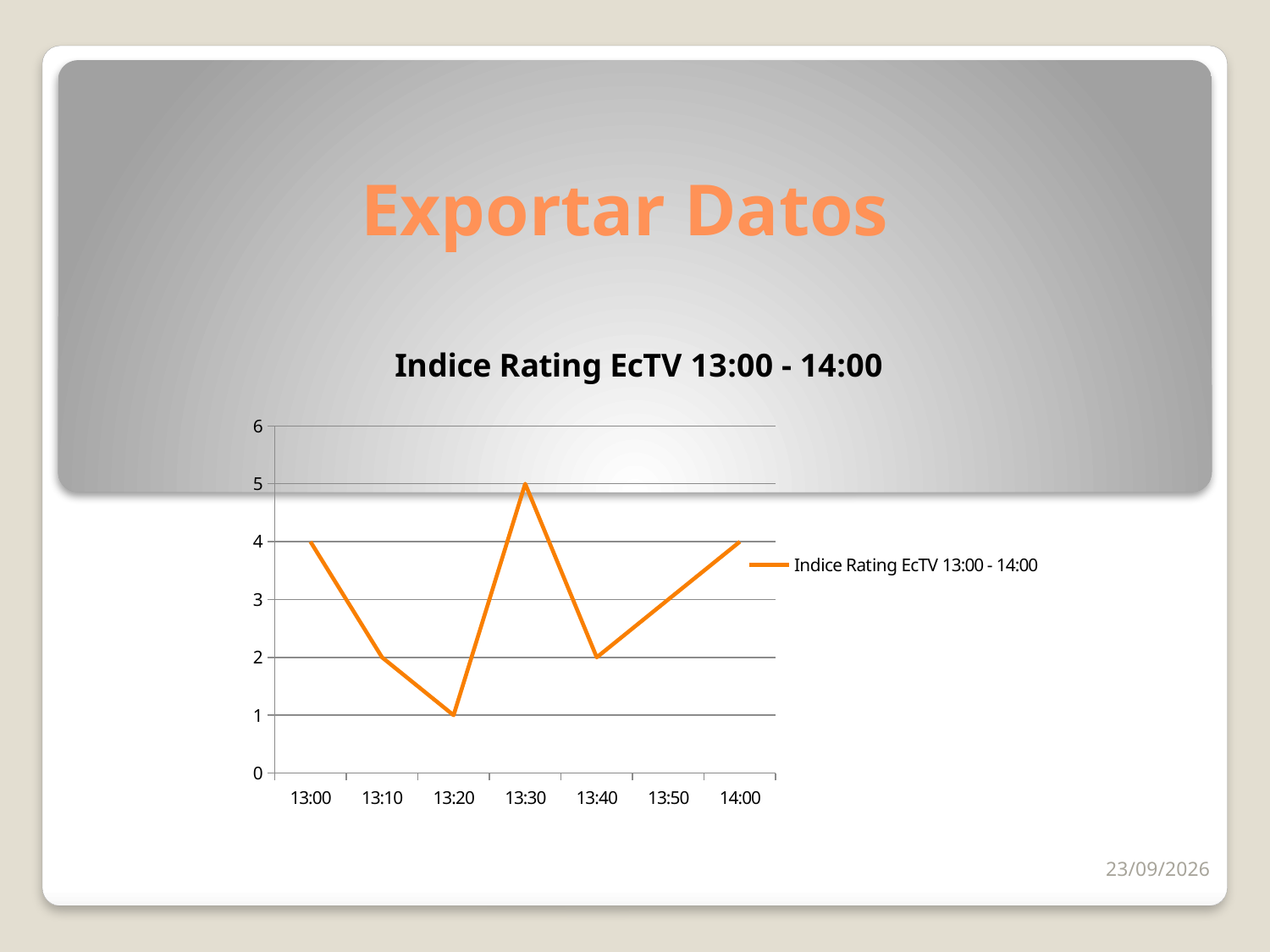
How many series does the legend list? 1 What is the value at 13:20? 1 What is the value at 13:00? 4 What type of chart is shown on the slide? line chart What is the value at 13:30? 5 Does the value rise or fall from 13:40 to 14:00? rise What is the difference between the values at 13:30 and 13:40? 3 At which time is the value highest? 13:30 How many time points are plotted on the x axis? 7 At which time is the value lowest? 13:20 What is the title of the chart? Indice Rating EcTV 13:00 - 14:00 Which is larger, the value at 13:10 or the value at 13:50? 13:50